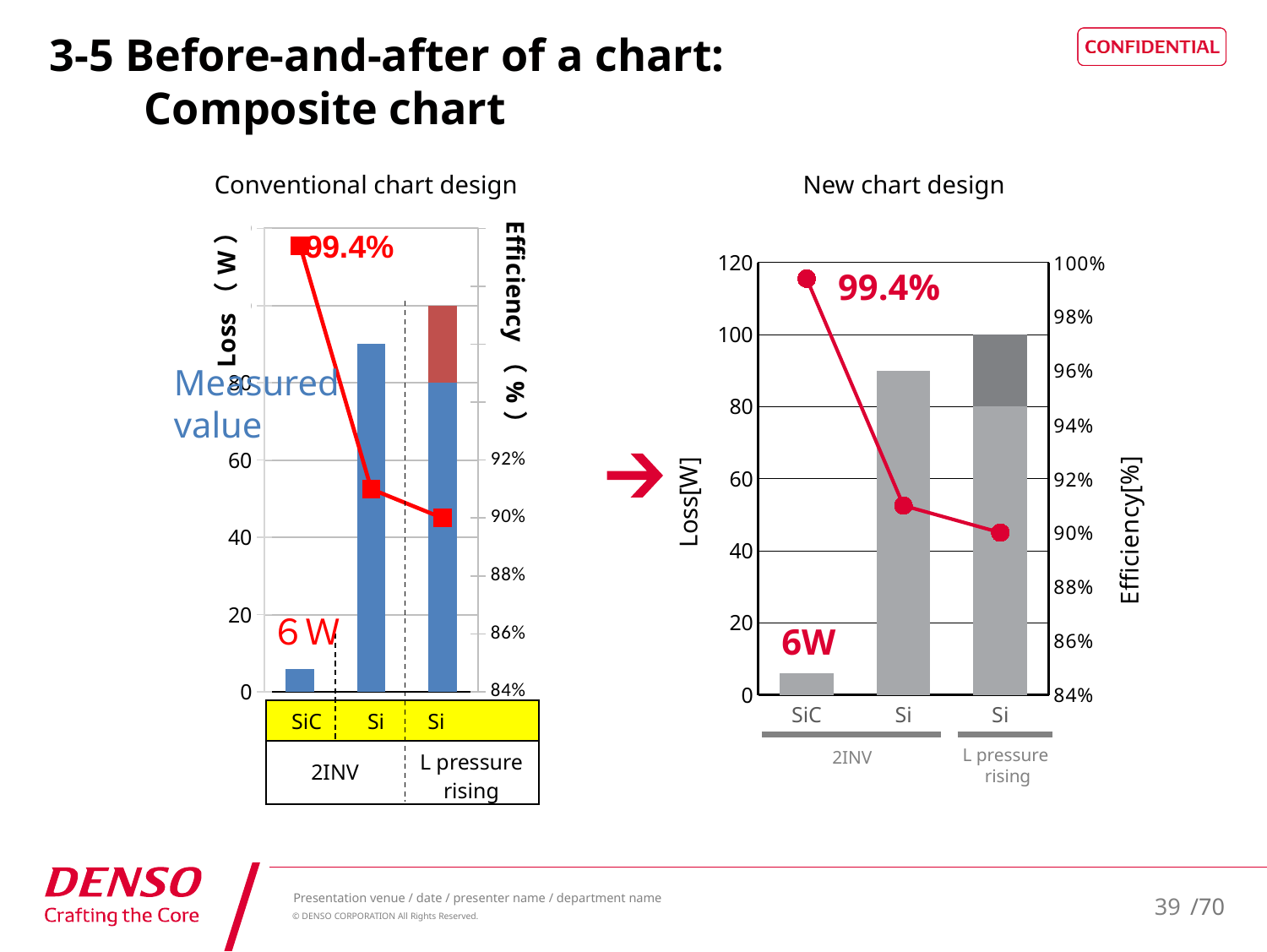
In the New chart design, is the loss bar for Si under 2INV greater or less than 80? greater In the New chart design, how many categories are shown on the x axis? 3 What kind of chart is the New chart design? Combined bar and line chart In the Conventional chart design, what efficiency value is labelled at the first point of the line? 99.4% In the Conventional chart design, what loss value is labelled for SiC? 6 W In the New chart design, does the efficiency line rise or fall from SiC to Si under L pressure rising? fall In the New chart design, what loss value is labelled for SiC? 6W In the New chart design, which category has the highest efficiency point? SiC In the New chart design, which category has the lowest loss bar? SiC In the New chart design, what is the efficiency value labelled for SiC? 99.4% In the New chart design, what is the label of the right-hand vertical axis? Efficiency[%] In the New chart design, is the efficiency for Si under L pressure rising greater or less than 94%? less